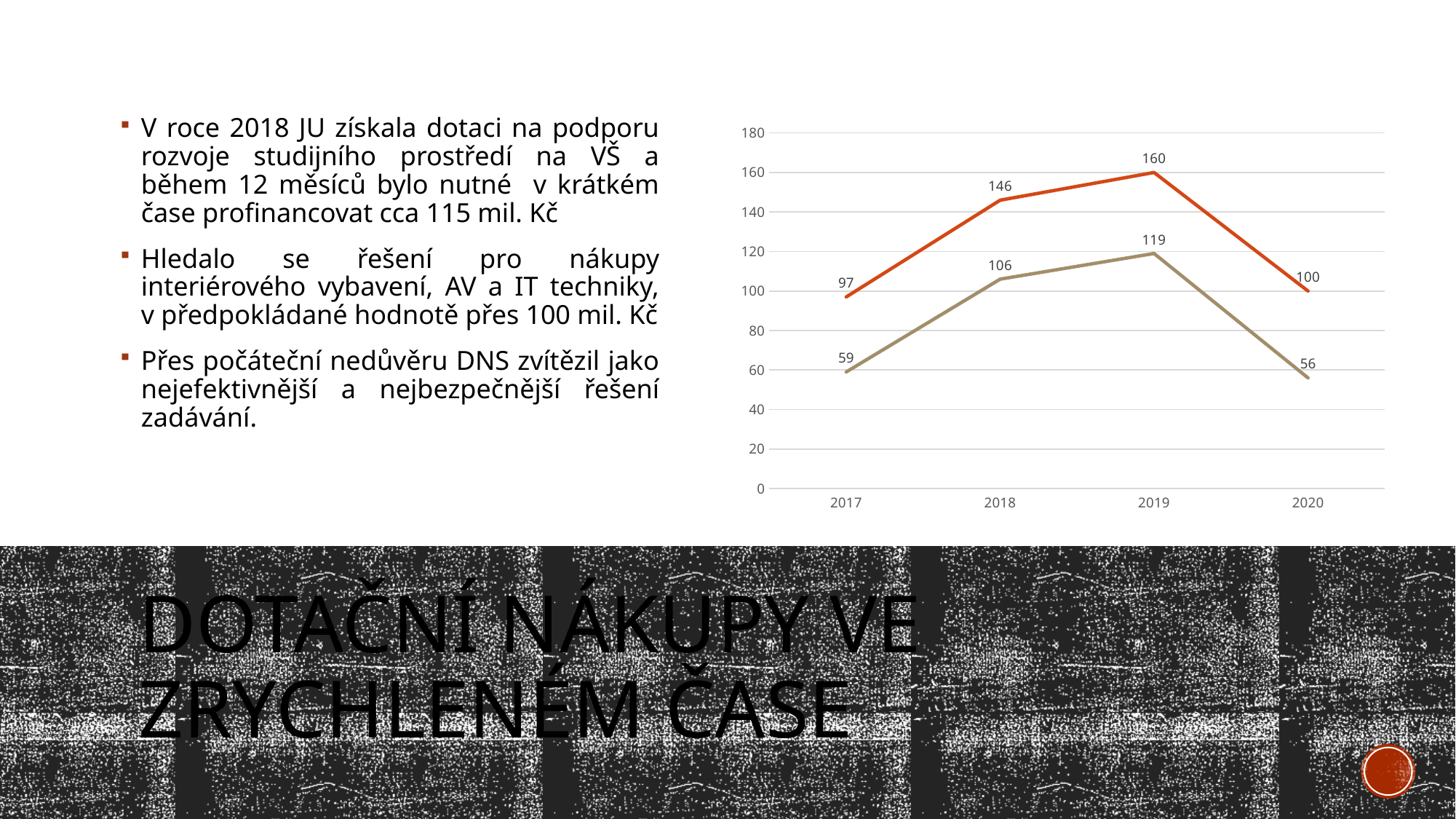
What is the value of the brown line in 2018? 106 Which is larger: the orange line's value in 2017 or its value in 2020? 2020 How many lines are plotted on the chart? 2 Does the orange line rise or fall between 2019 and 2020? fall What is the value of the orange line in 2020? 100 How many years are shown on the x axis of the chart? 4 What kind of chart is shown on the slide? line chart In which year does the orange line reach its highest value? 2019 What is the difference between the orange line and the brown line in 2018? 40 What is the value of the orange line in 2019? 160 In which year does the brown line have its lowest value? 2020 What is the value of the brown line in 2017? 59